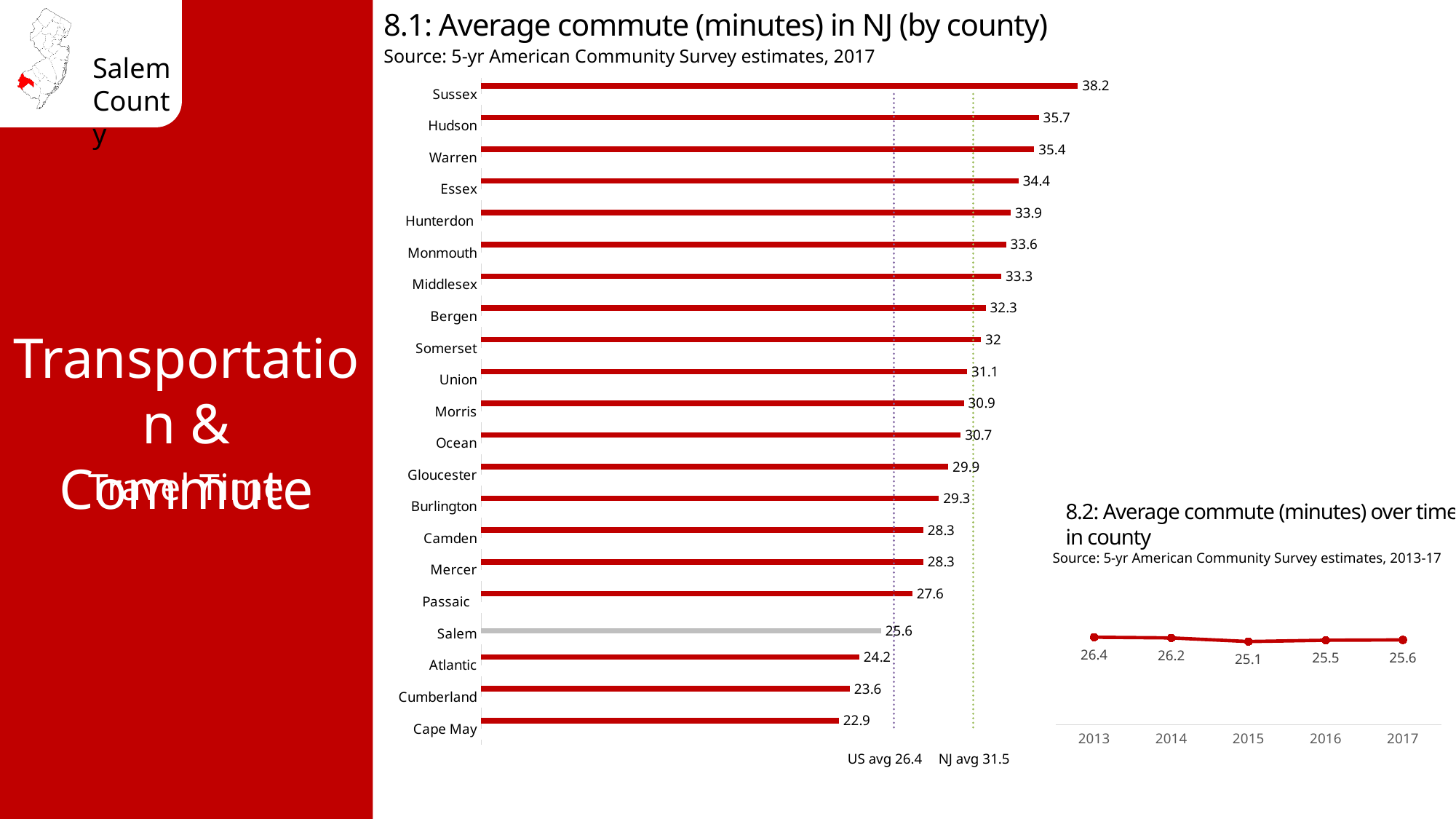
In chart 8.1 (Average commute in NJ by county), what is the average commute for Hunterdon? 33.9 What kind of chart is chart 8.1 (Average commute in NJ by county)? Bar chart In chart 8.1 (Average commute in NJ by county), what is the difference between the values for Sussex and Salem? 12.6 In chart 8.1 (Average commute in NJ by county), which county has the highest average commute? Sussex In chart 8.1 (Average commute in NJ by county), what NJ average is marked by the dotted reference line? 31.5 In chart 8.1 (Average commute in NJ by county), how many counties are shown? 21 In chart 8.2 (Average commute over time in county), what is the value for 2015? 25.1 In chart 8.1 (Average commute in NJ by county), which county has the lowest average commute? Cape May In chart 8.1 (Average commute in NJ by county), which has a larger value, Bergen or Union? Bergen In chart 8.1 (Average commute in NJ by county), what is the average commute for Salem? 25.6 In chart 8.2 (Average commute over time in county), which year has the lowest value? 2015 In chart 8.2 (Average commute over time in county), what is the difference between the 2013 and 2017 values? 0.8